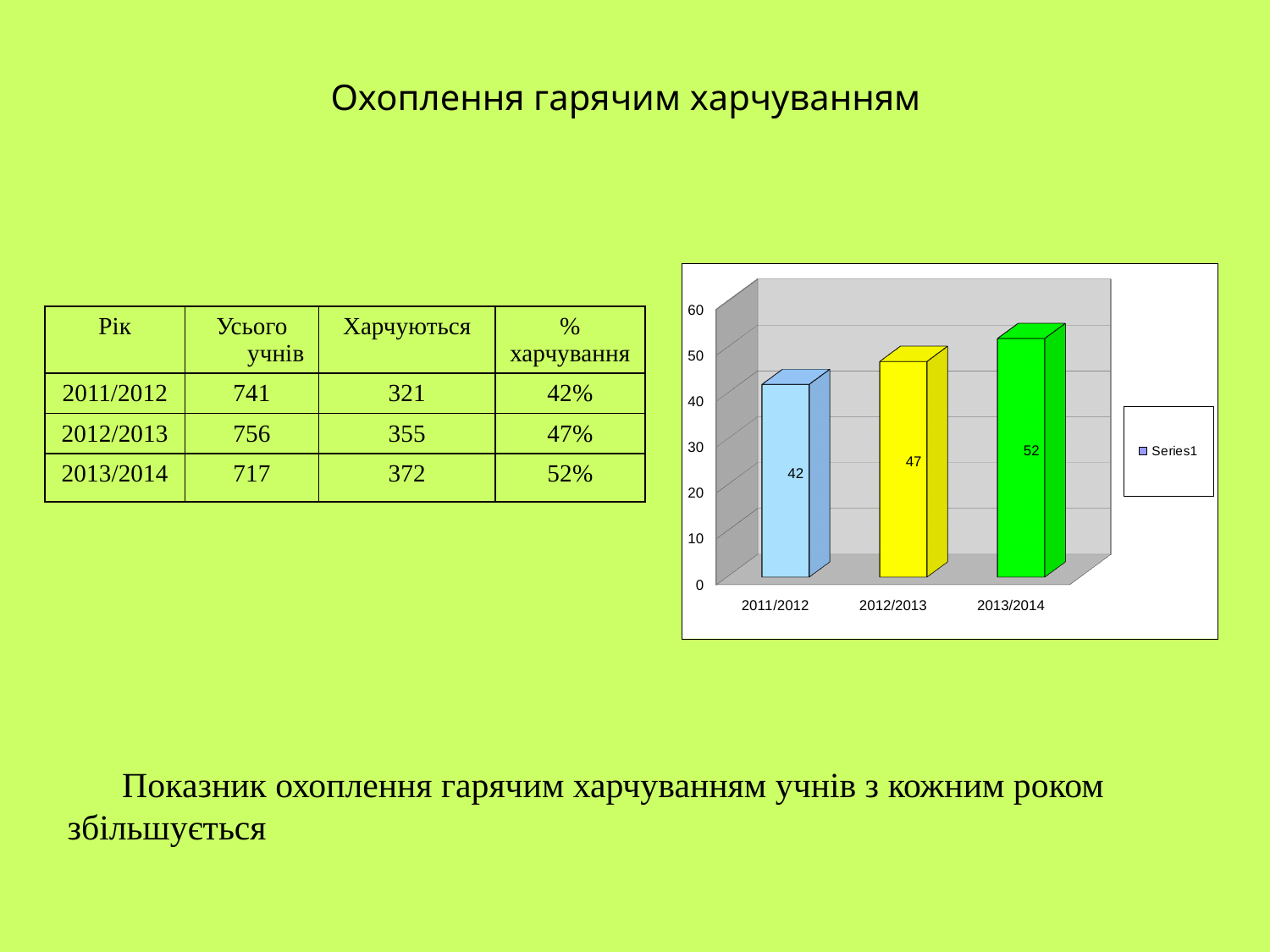
Is the value for 2013/2014 greater or less than 50? greater What is the value for 2011/2012 in the chart? 42 What is the difference between the values for 2012/2013 and 2011/2012? 5 What is the value for 2013/2014 in the chart? 52 What is the value for 2012/2013 in the chart? 47 What is the difference between the values for 2013/2014 and 2011/2012? 10 Which category has the lowest value in the chart? 2011/2012 Which is larger, the value for 2012/2013 or the value for 2013/2014? 2013/2014 What kind of chart is shown on the slide? bar chart Do the values rise or fall from 2011/2012 to 2013/2014? rise Which category has the highest value in the chart? 2013/2014 How many categories are shown on the x axis of the chart? 3